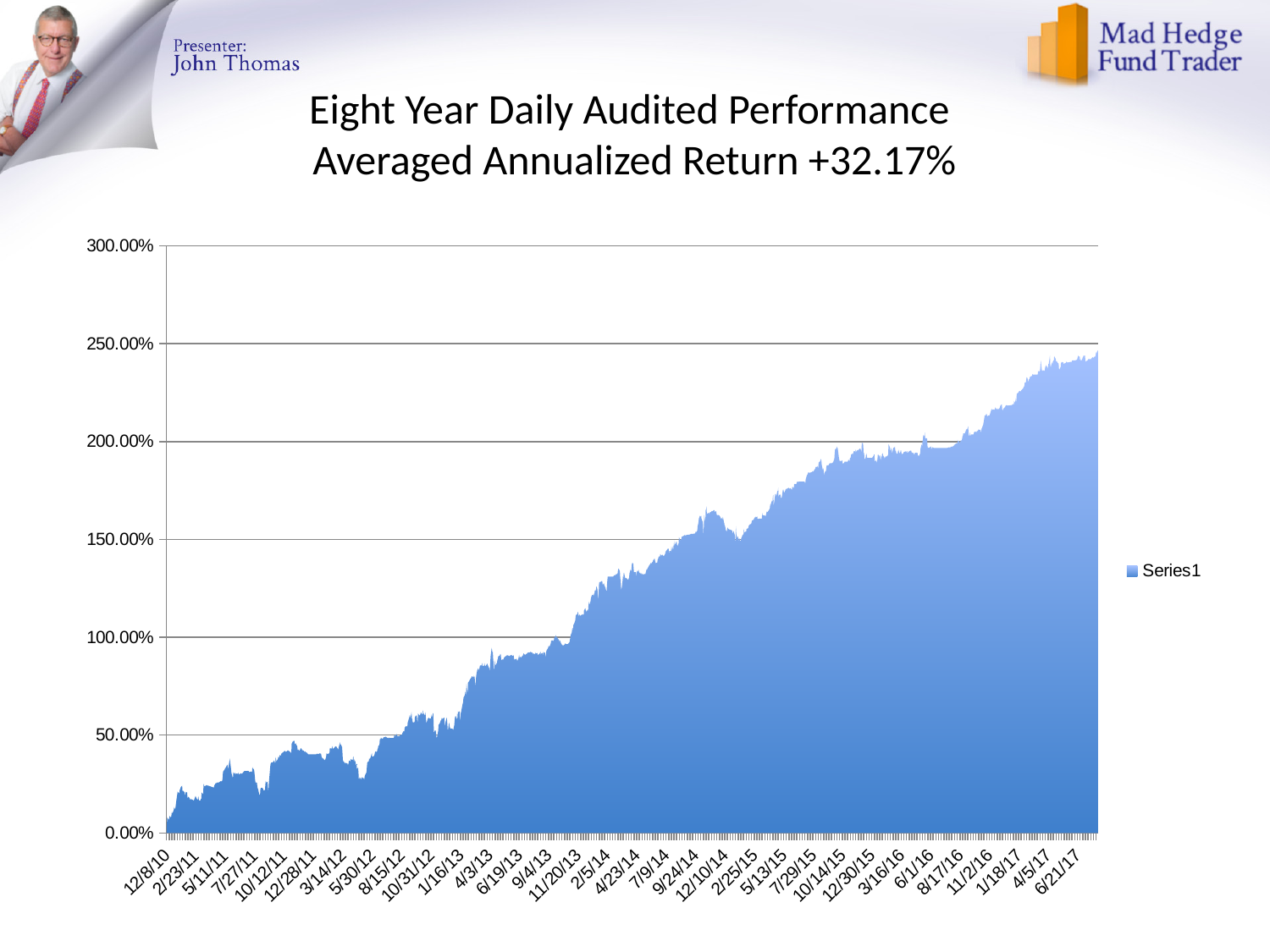
Is the value for 6/21/17 greater or less than 200.00%? greater What is the name of the series shown in the legend? Series1 How many series does the legend list? 1 What is the title of the chart on the slide? Eight Year Daily Audited Performance Averaged Annualized Return +32.17% What kind of chart is shown on the slide? area chart Is the value for 1/18/17 greater or less than 200.00%? greater Which is larger, the value for 4/3/13 or the value for 9/24/14? 9/24/14 Is the value for 2/5/14 greater or less than 100.00%? greater Do the values generally rise or fall from 12/8/10 to 6/21/17? rise